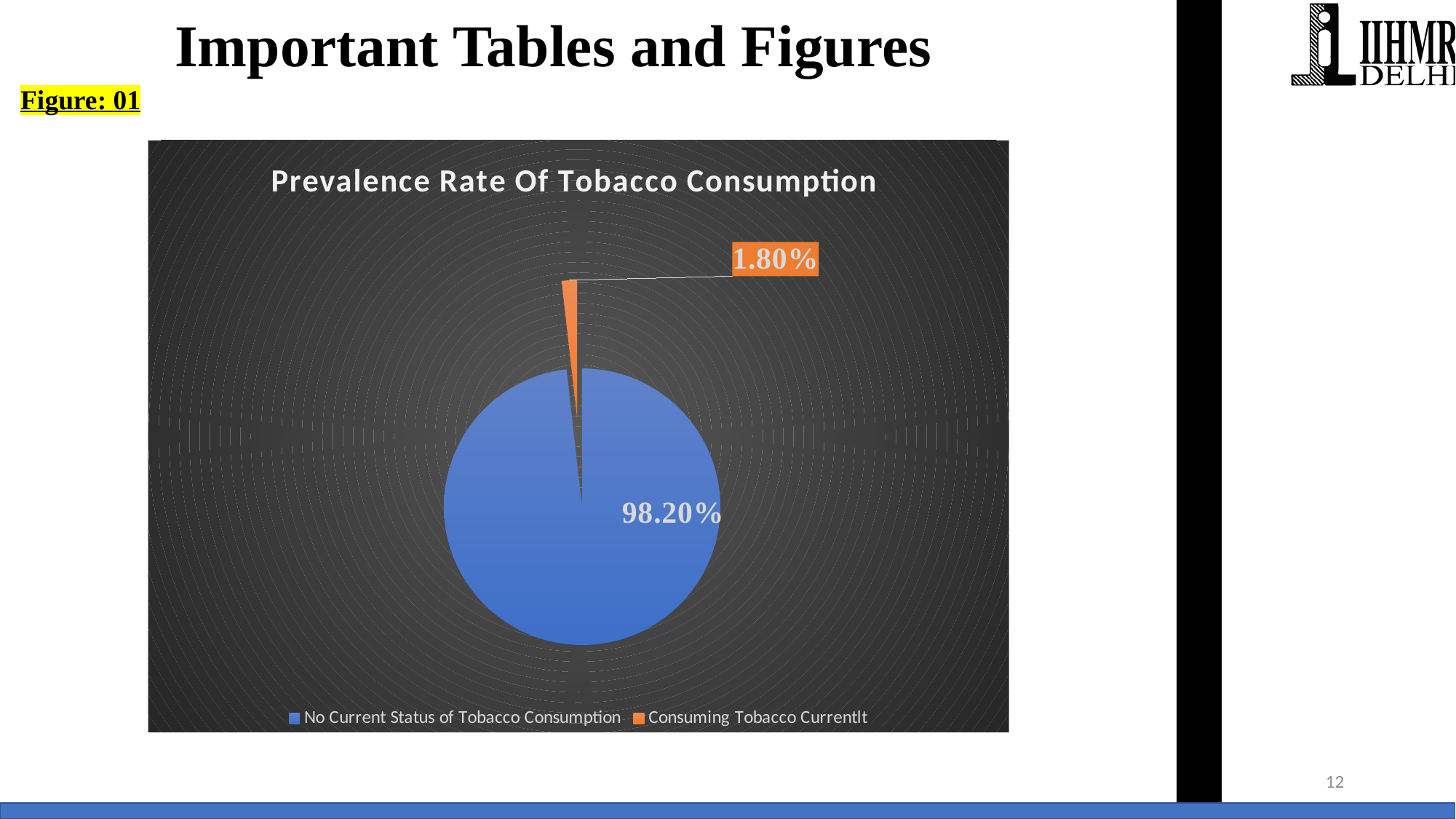
What is the total of the two slice percentages? 100.00% What is the title of the chart? Prevalence Rate Of Tobacco Consumption What share of the pie is labelled for 'No Current Status of Tobacco Consumption'? 98.20% Which slice of the pie is the largest? No Current Status of Tobacco Consumption How many slices does the pie chart have? 2 What share of the pie is labelled for 'Consuming Tobacco Currentlt'? 1.80% What colour is the slice for 'Consuming Tobacco Currentlt'? Orange How many entries does the legend list? 2 What kind of chart is shown on the slide? Pie chart What is the difference between the two slice percentages? 96.40% Which is larger: the slice for 'No Current Status of Tobacco Consumption' or the slice for 'Consuming Tobacco Currentlt'? No Current Status of Tobacco Consumption Which slice of the pie is the smallest? Consuming Tobacco Currentlt